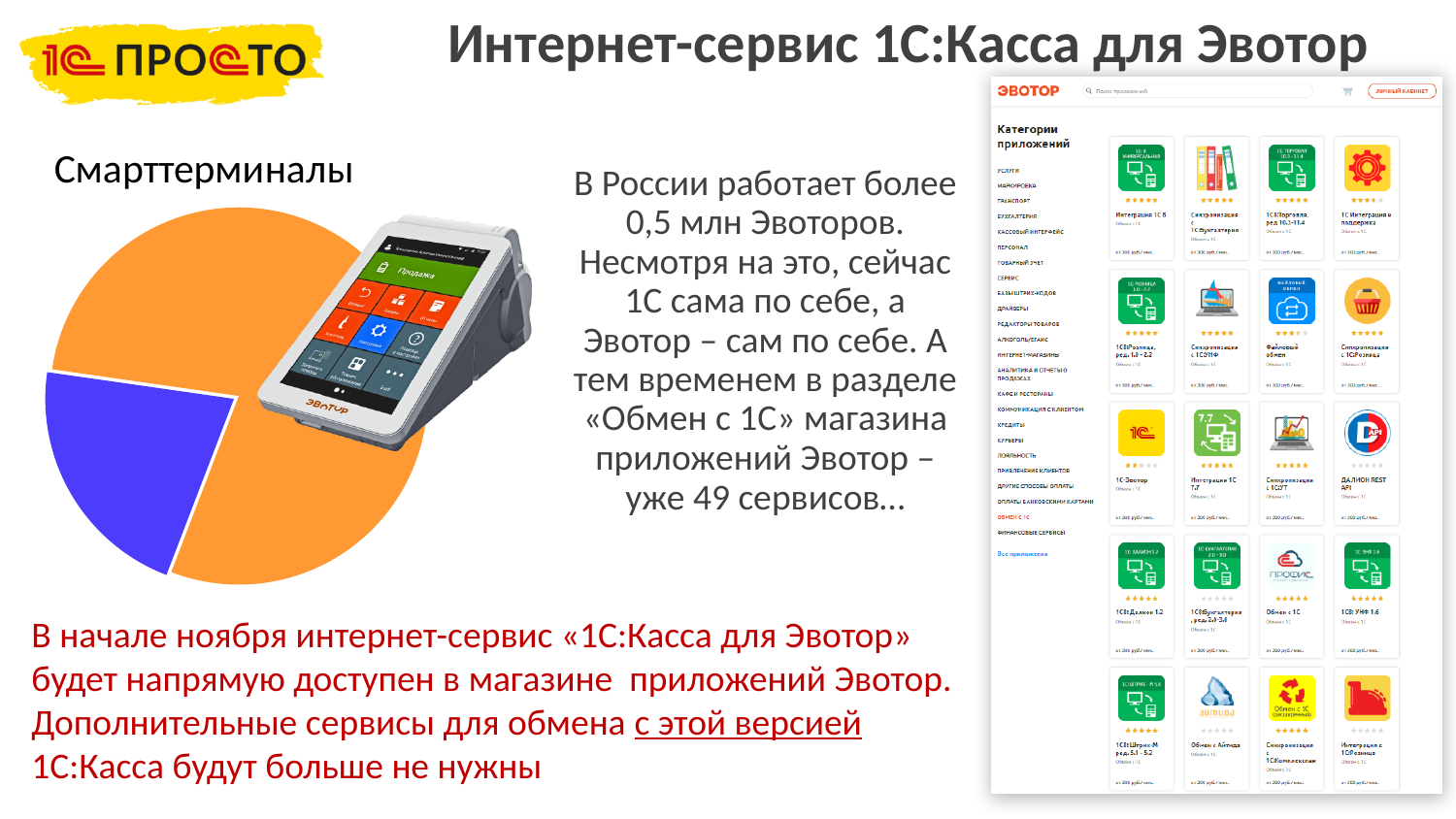
In the "Смарттерминалы" pie chart, which slice is the smallest? the blue slice What kind of chart is shown under the heading "Смарттерминалы"? pie chart How many slices does the "Смарттерминалы" pie chart have? 2 In the "Смарттерминалы" pie chart, which slice is larger, the orange one or the blue one? the orange one In the "Смарттерминалы" pie chart, which slice is the largest? the orange slice What is the heading shown above the pie chart on the left of the slide? Смарттерминалы Which slice of the "Смарттерминалы" pie chart is pulled out (exploded) from the rest of the pie? the blue slice